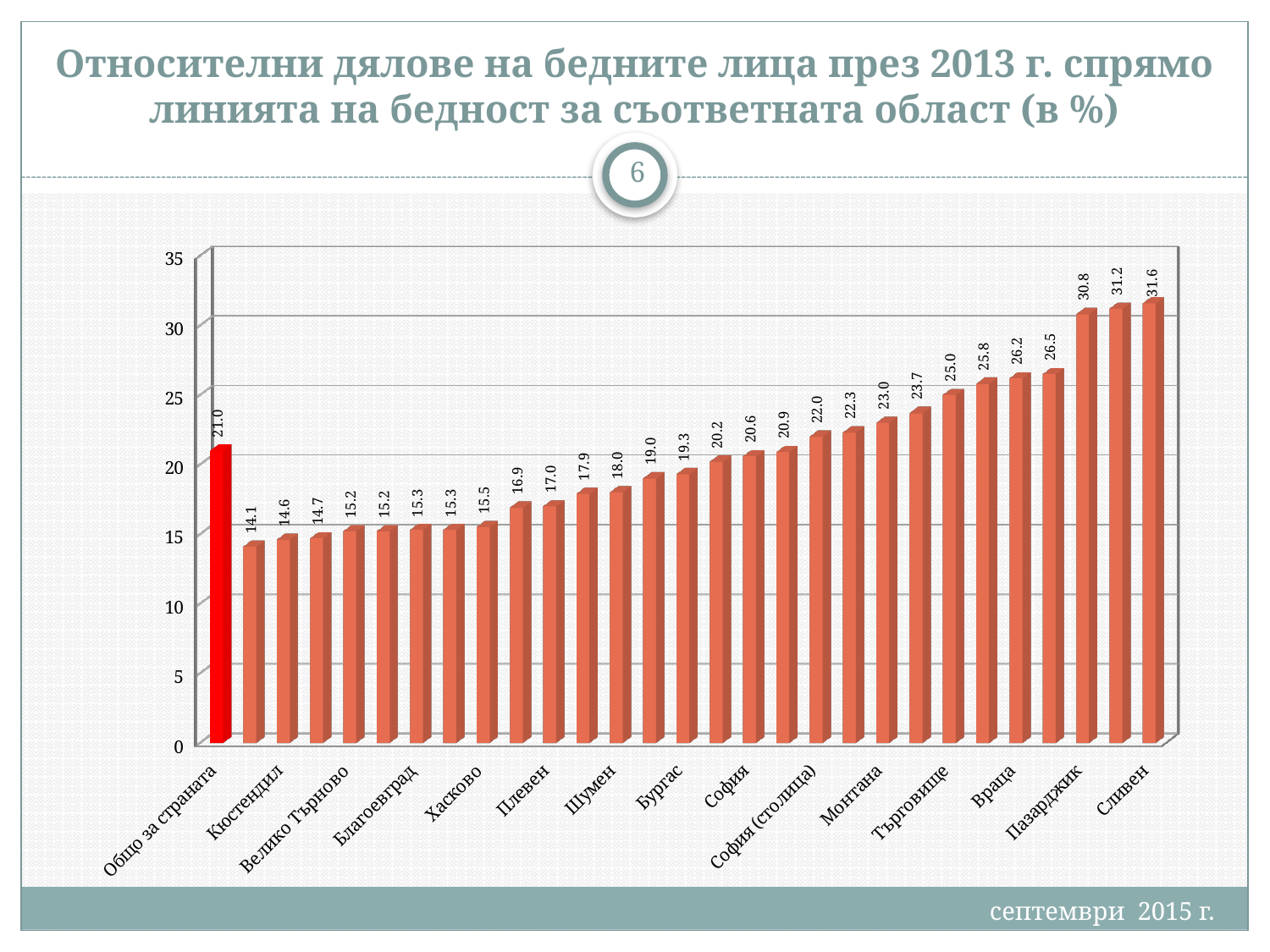
Do the values rise or fall from left to right after the first bar? rise What is the value for Търговище? 25.0 What is the lowest value shown in the chart? 14.1 Which is larger, the value for Пазарджик or the value for Враца? Пазарджик What type of chart is shown on the slide? bar chart Which category has the highest value? Сливен How many bars are plotted in the chart? 29 What is the value for Монтана? 23.0 What is the difference between the values for Сливен and Общо за страната? 10.6 What is the value for Общо за страната? 21.0 What is the value for Сливен? 31.6 Which category is shown with a red bar? Общо за страната